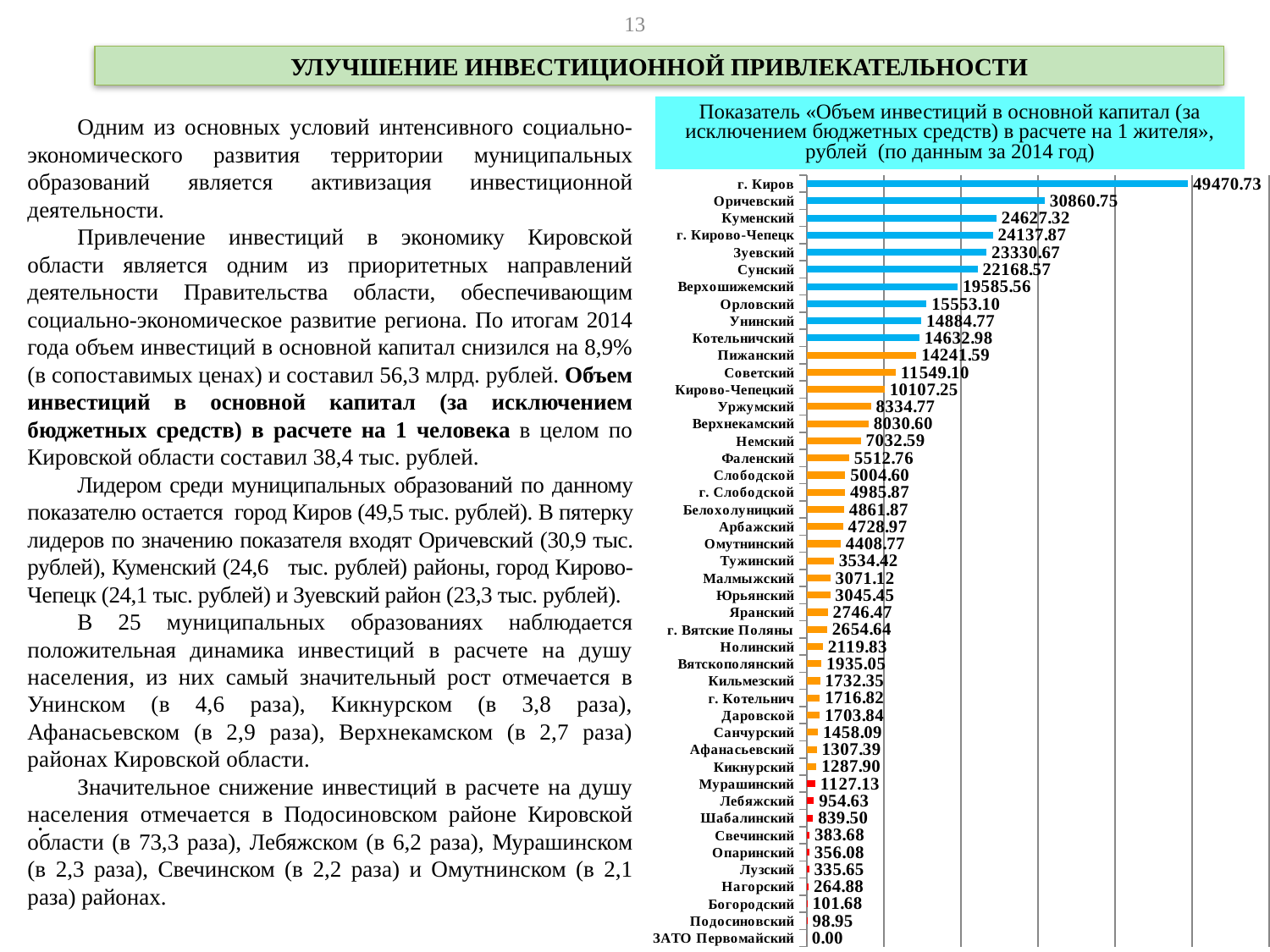
Which has a larger value, Куменский or Сунский? Куменский What kind of chart is shown on the slide? bar chart What is the value for г. Киров? 49470.73 What is the difference between the values for г. Киров and Оричевский? 18609.98 Which category has the lowest value? ЗАТО Первомайский What is the value for Подосиновский? 98.95 What is the value for Зуевский? 23330.67 What is the value for Афанасьевский? 1307.39 How many categories are plotted in the chart? 45 Which has a larger value, Лебяжский or Мурашинский? Мурашинский Which category has the highest value? г. Киров What is the difference between the values for Орловский and Унинский? 668.33